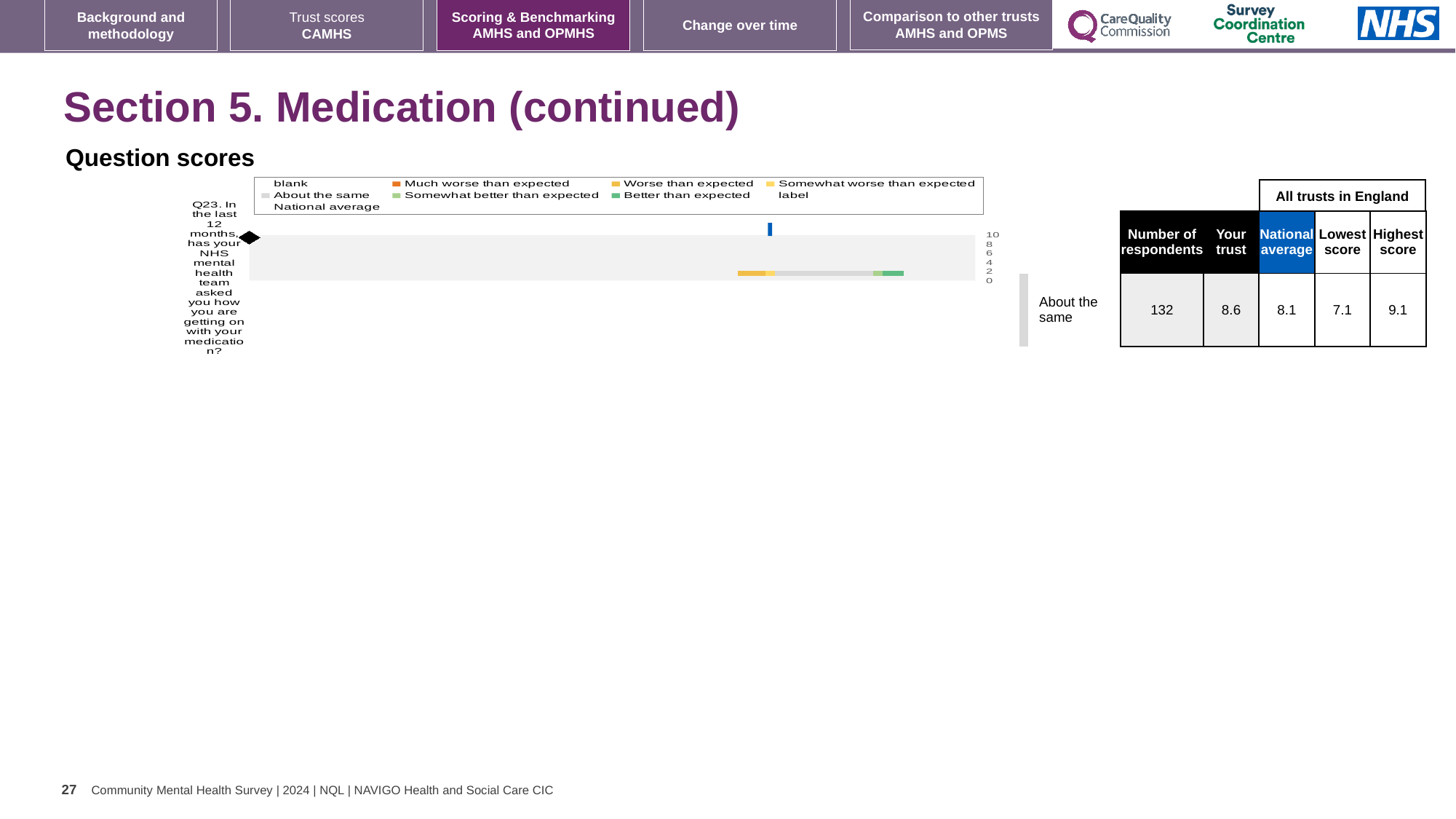
According to the table beside the chart, what is the national average score for Q23? 8.1 Which question is plotted in the question scores chart? Q23. In the last 12 months, has your NHS mental health team asked you how you are getting on with your medication? How many questions are plotted in the question scores chart? 1 According to the table beside the chart, what is the lowest score among all trusts in England for Q23? 7.1 According to the table beside the chart, what is the 'Your trust' score for Q23? 8.6 What benchmark category is shown next to the Q23 bar? About the same For Q23, what is the difference between the highest score and the lowest score among all trusts in England? 2.0 According to the table beside the chart, how many respondents answered Q23? 132 For Q23, which is larger: the 'Your trust' score or the national average? Your trust What colour does the legend use for 'Better than expected'? green What kind of chart is used to show the Q23 question score? bar chart According to the table beside the chart, what is the highest score among all trusts in England for Q23? 9.1